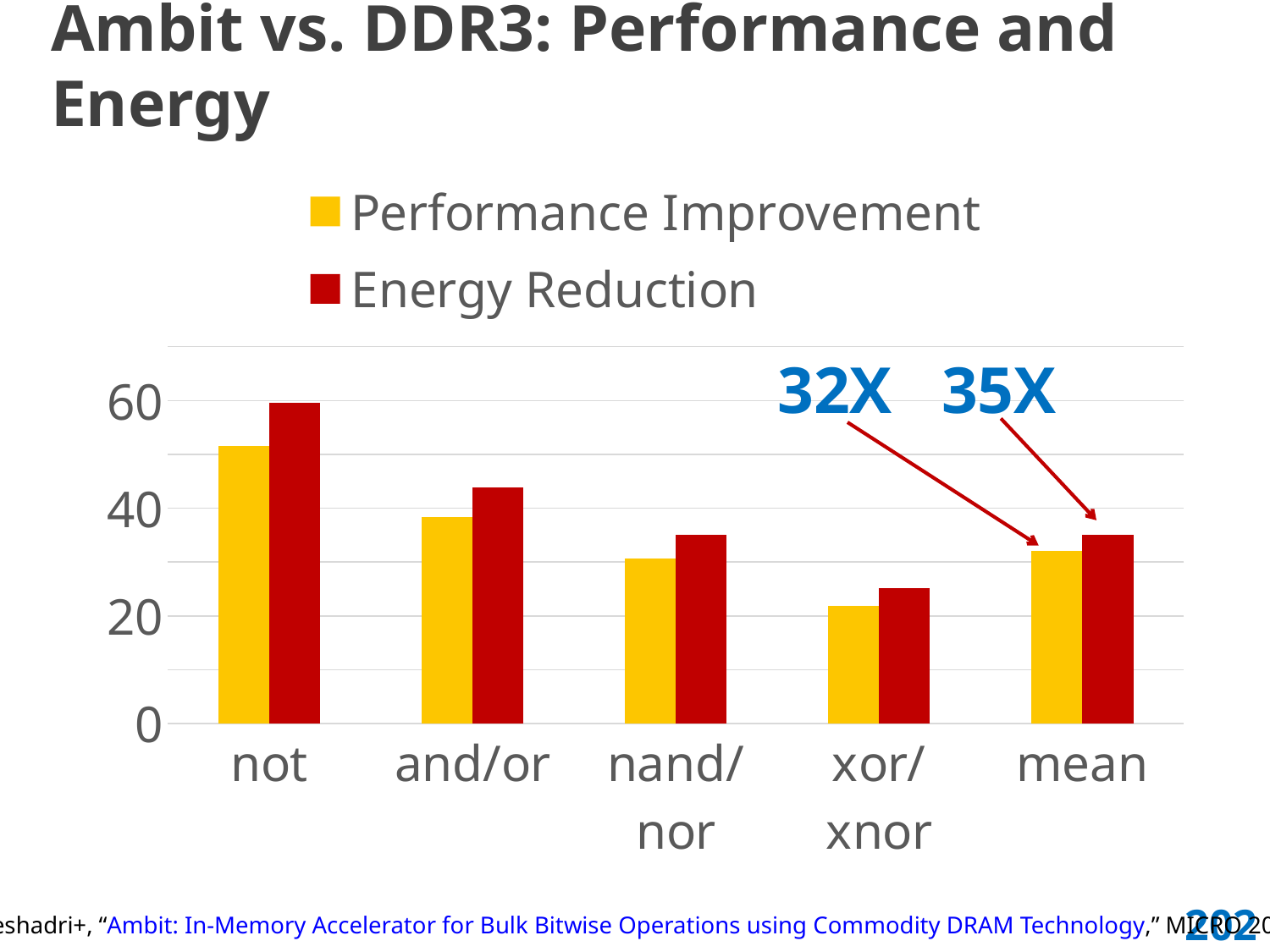
Which category has the highest Performance Improvement? not How many categories are shown on the x axis? 5 What is the Performance Improvement value for the mean category? 32X Do the Performance Improvement values rise or fall from not to xor/xnor along the x axis? fall Is the Performance Improvement value for xor/xnor greater or less than 40? less What kind of chart is shown on the slide? bar chart How many series does the legend list? 2 What colour represents Energy Reduction in the legend? red Is the Energy Reduction value for not greater or less than 40? greater Which category has the lowest Energy Reduction? xor/xnor What is the Energy Reduction value for the mean category? 35X For the not category, which is larger: Performance Improvement or Energy Reduction? Energy Reduction